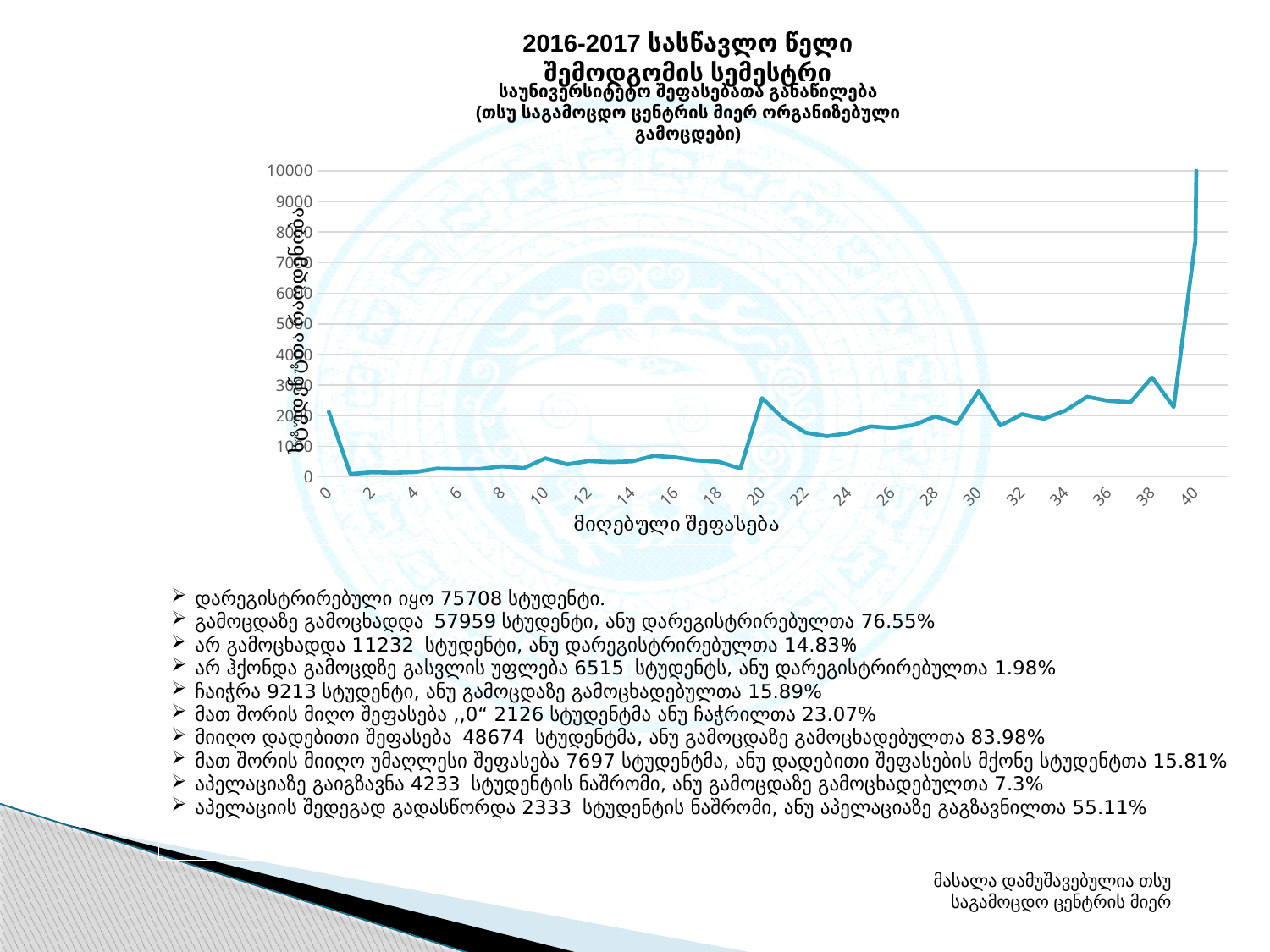
Does the line rise or fall between score 20 and score 22? fall Is the value at score 40 greater or less than 9000? less Is the value at score 20 greater or less than 2000? greater Is the value at score 16 greater or less than 1000? less What is the highest value shown on the y axis? 10000 What is the label of the x axis? მიღებული შეფასება What kind of chart is shown on the slide? line chart Does the line rise or fall between score 0 and score 1? fall